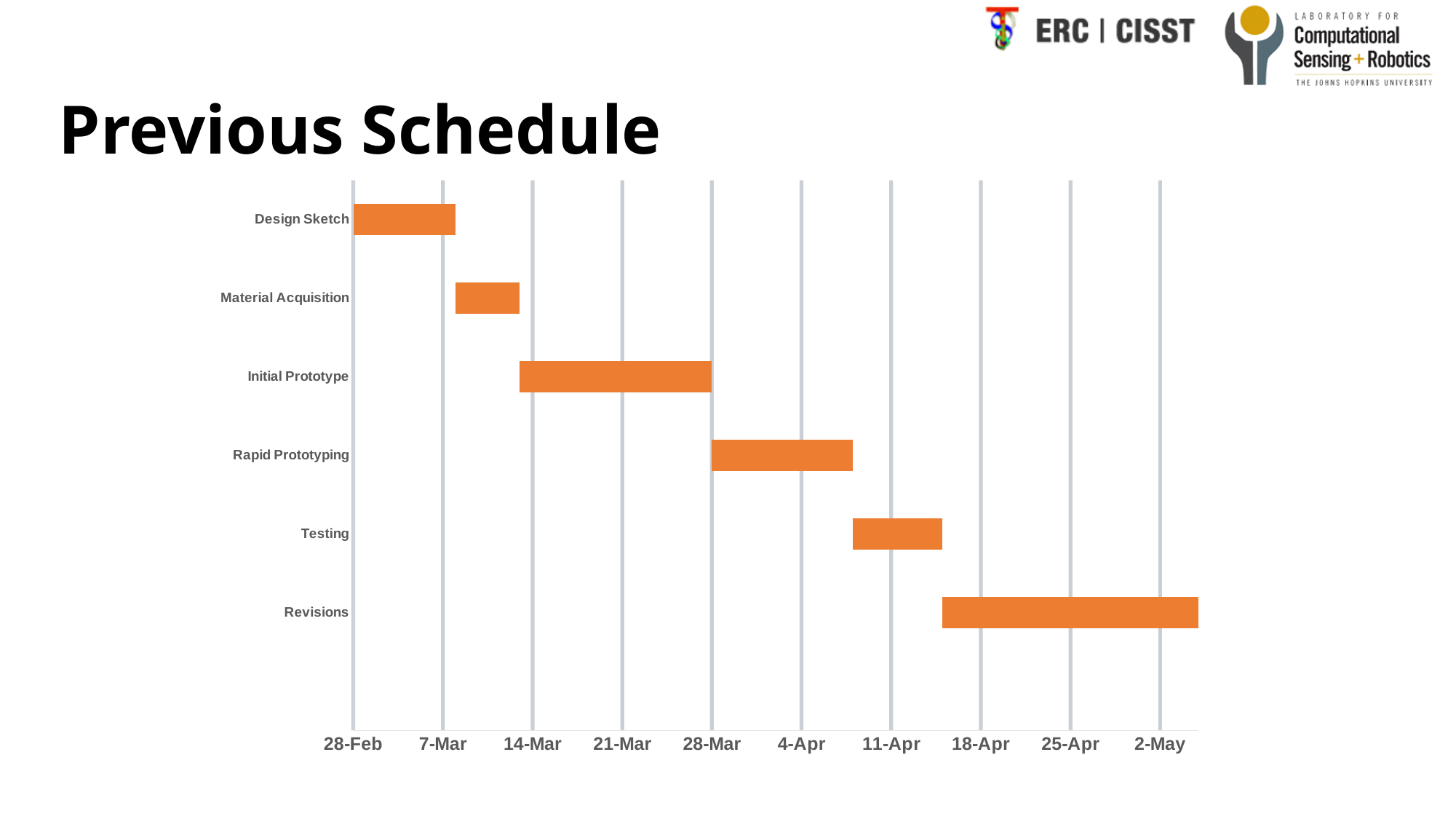
Which task has the longest bar in the chart? Revisions On which axis date does the Rapid Prototyping bar begin? 28-Mar On which axis date does the Initial Prototype bar end? 28-Mar What colour are the bars in the chart? Orange What kind of chart is shown on the slide? Bar chart (Gantt chart) Which bar is longer, Initial Prototype or Testing? Initial Prototype Does the Testing bar start before or after 11-Apr? before Does the Revisions bar end before or after 2-May? after What is the title of the slide containing the chart? Previous Schedule How many tasks are listed on the vertical axis of the chart? 6 On which axis date does the Design Sketch bar begin? 28-Feb Which task has the shortest bar in the chart? Material Acquisition